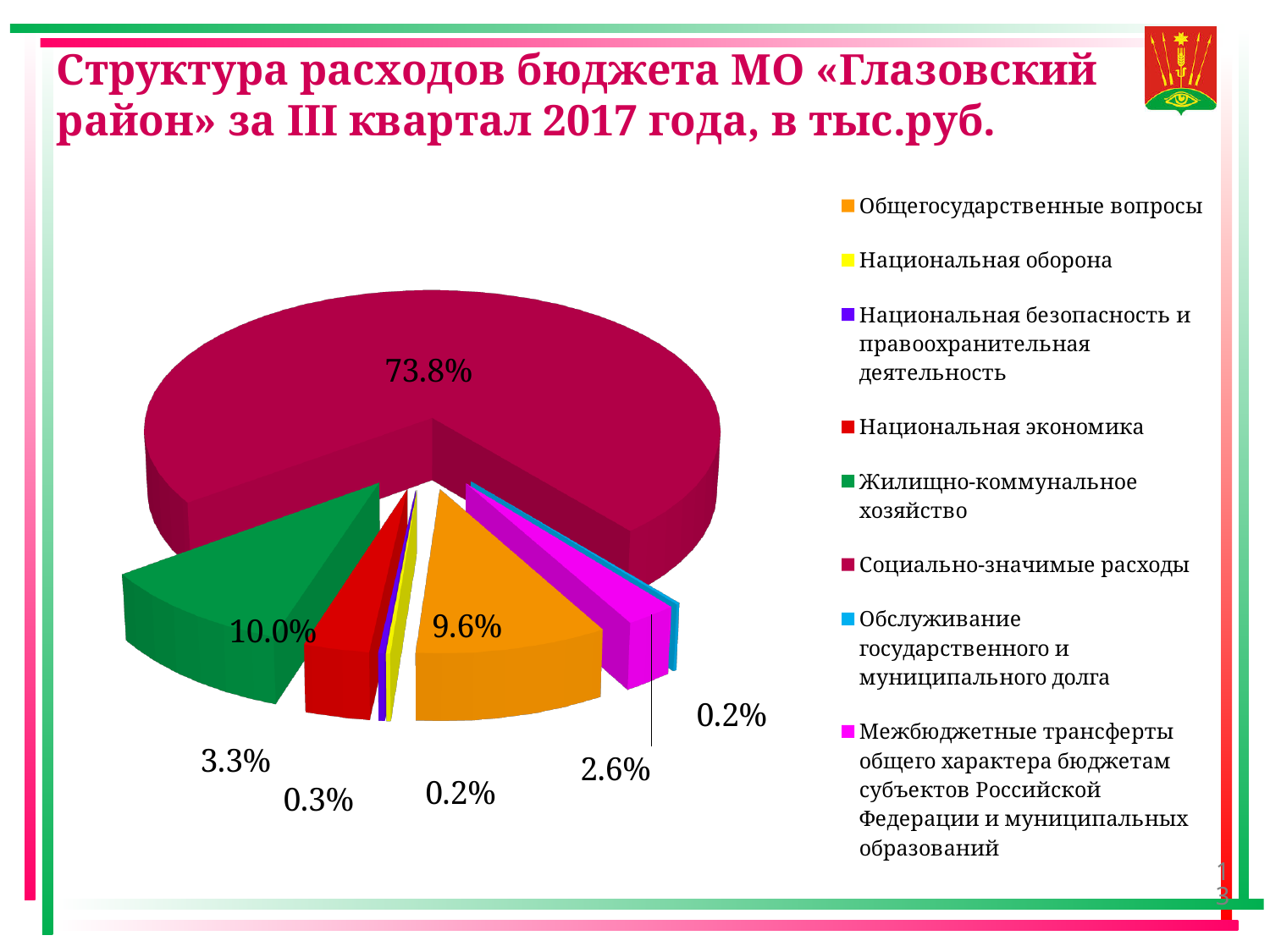
Which is larger: «Жилищно-коммунальное хозяйство» or «Общегосударственные вопросы»? Жилищно-коммунальное хозяйство What is the value shown for «Межбюджетные трансферты общего характера бюджетам субъектов Российской Федерации и муниципальных образований»? 2.6% How many categories does the legend of the pie chart list? 8 What is the value shown for «Жилищно-коммунальное хозяйство»? 10.0% What kind of chart is shown on the slide? Pie chart What is the difference between the shares of «Жилищно-коммунальное хозяйство» and «Общегосударственные вопросы»? 0.4 percentage points By how many percentage points does «Социально-значимые расходы» exceed «Жилищно-коммунальное хозяйство»? 63.8 percentage points What is the value shown for «Общегосударственные вопросы»? 9.6% What is the value shown for «Национальная экономика»? 3.3% What period does the chart title say the budget expenditure structure covers? III квартал 2017 года Which category has the largest slice of the pie? Социально-значимые расходы What share of the pie does «Социально-значимые расходы» take? 73.8%